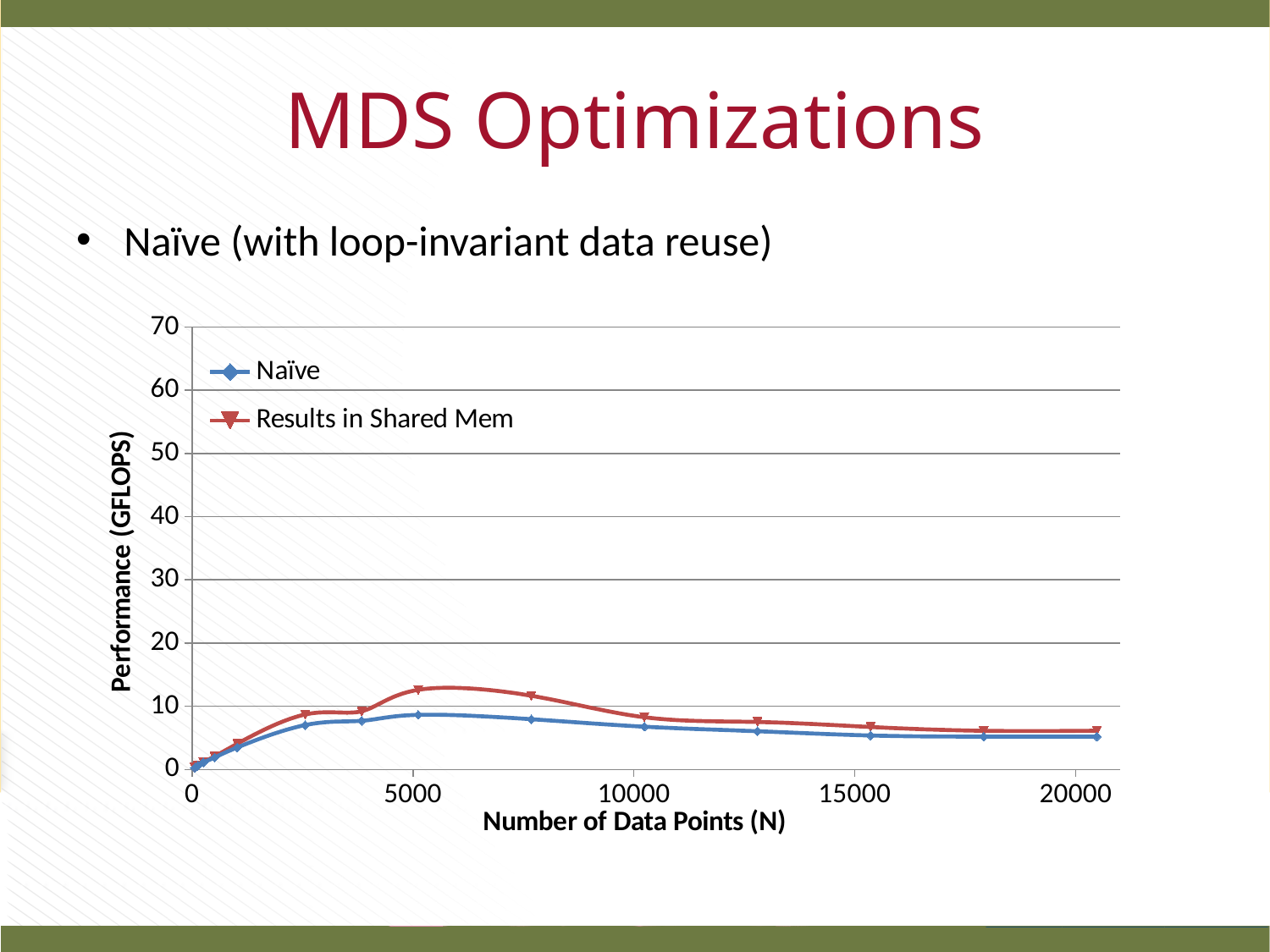
At around 5000 data points, which series has the higher performance, Naïve or Results in Shared Mem? Results in Shared Mem Is the peak value of the Results in Shared Mem series greater or less than 20? less Which series reaches the highest performance value on the chart? Results in Shared Mem What is the label of the chart's y axis? Performance (GFLOPS) How many series does the chart's legend list? 2 Is the value for Naïve at around 5000 data points greater or less than 10? less Does the Results in Shared Mem series rise or fall between 0 and 5000 data points? rise What are the two series named in the chart's legend? Naïve and Results in Shared Mem Is the value for Naïve at around 20000 data points greater or less than 10? less What kind of chart is shown on the slide? line chart Does the Naïve series rise or fall between 5000 and 20000 data points? fall